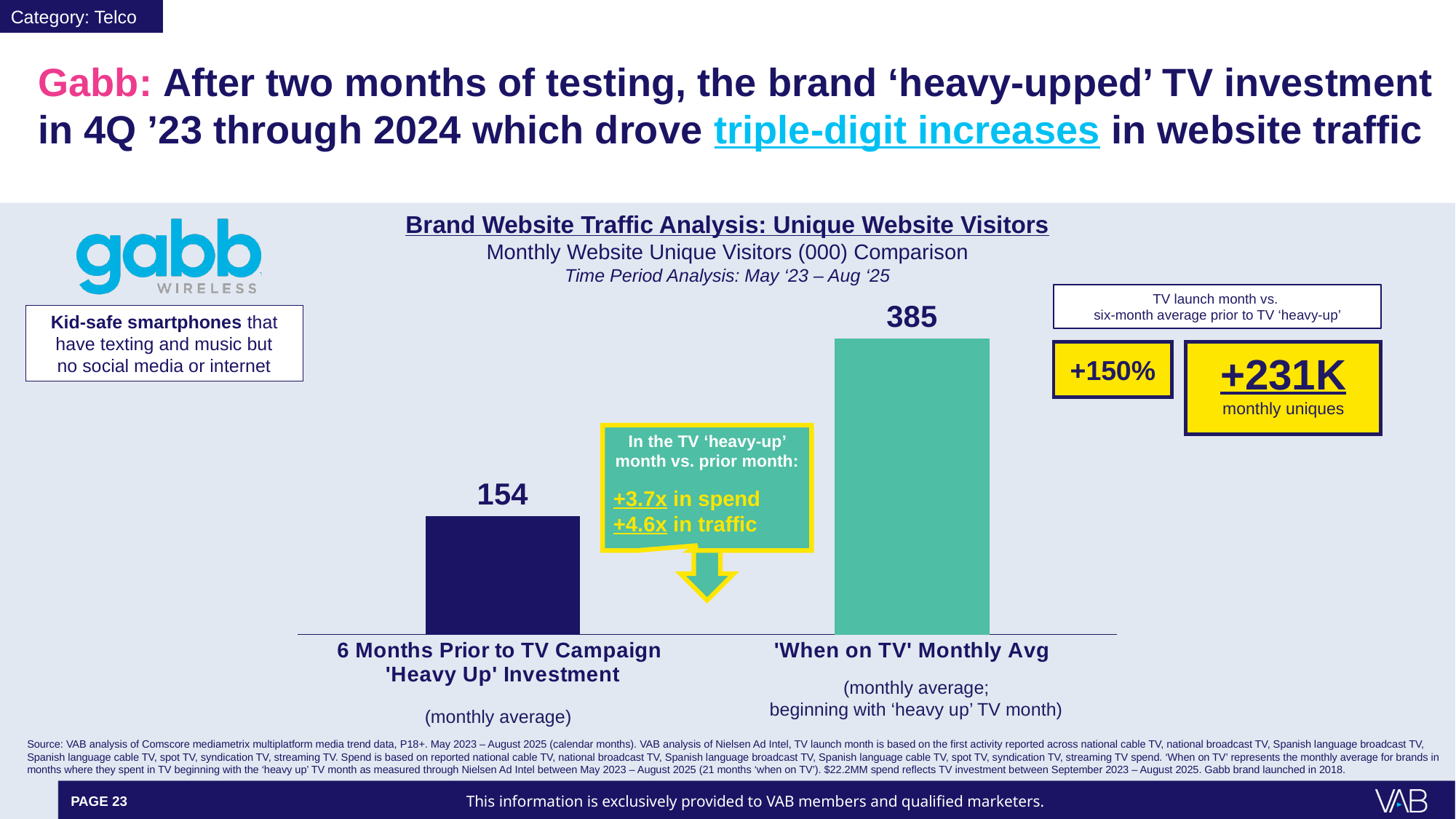
Which is larger: the value for 'When on TV' Monthly Avg or the value for 6 Months Prior to TV Campaign? 'When on TV' Monthly Avg Which category has the highest value? 'When on TV' Monthly Avg Which category has the lowest value? 6 Months Prior to TV Campaign 'Heavy Up' Investment What is the value for '6 Months Prior to TV Campaign Heavy Up Investment'? 154 Do the values rise or fall from left to right across the chart? Rise How many bars are shown in the chart? 2 What time period does the chart analyze? May '23 – Aug '25 What kind of chart is shown on the slide? Bar chart What is the difference between the 'When on TV' Monthly Avg value and the 6 Months Prior to TV Campaign value? 231 What is the title of the chart? Brand Website Traffic Analysis: Unique Website Visitors What percentage increase is shown for the TV launch month vs. the six-month average prior to TV 'heavy-up'? +150% What is the value for 'When on TV' Monthly Avg? 385